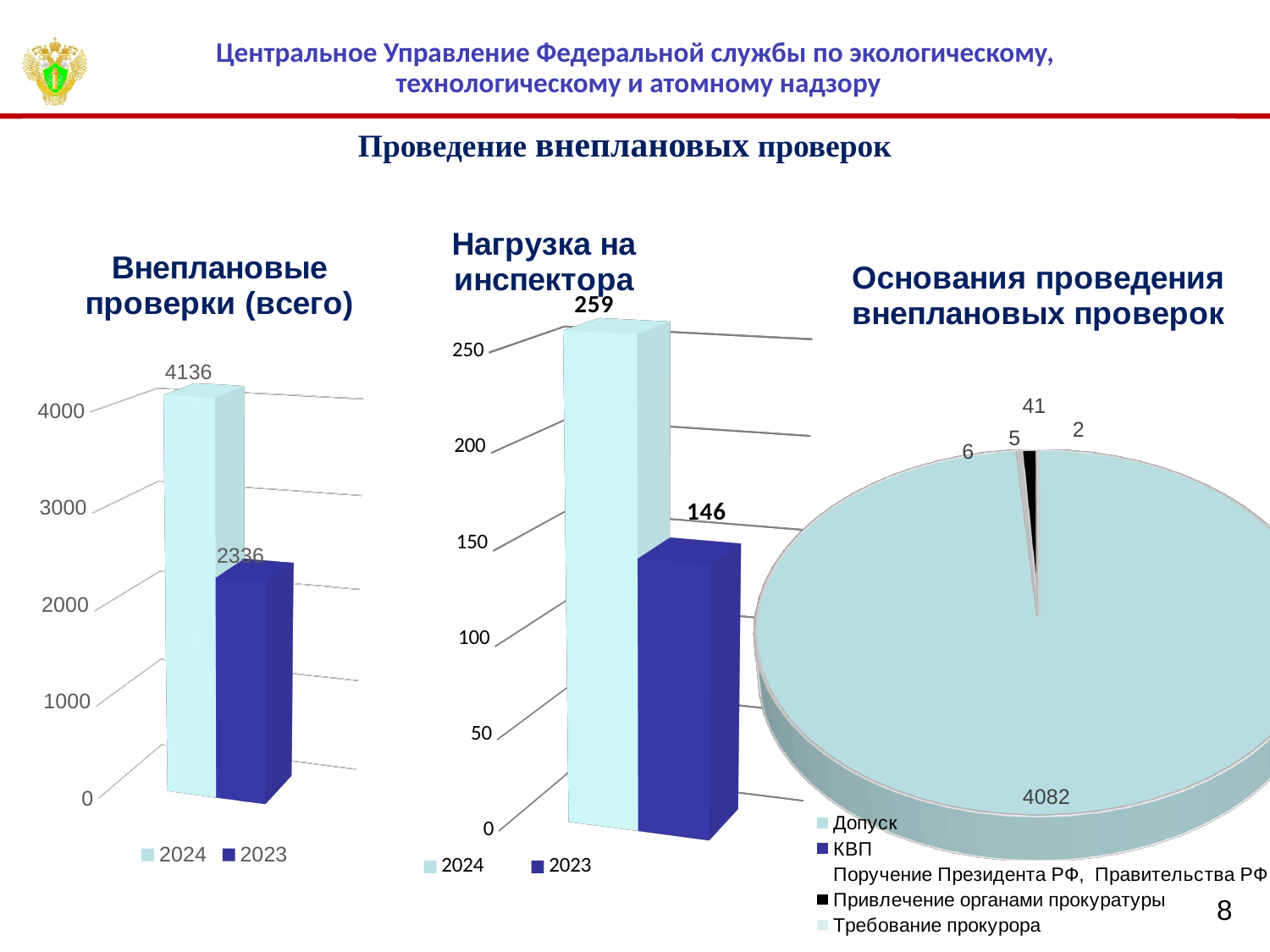
In the chart 'Нагрузка на инспектора', how many series does the legend list? 2 In the chart 'Нагрузка на инспектора', what is the value for 2023? 146 What kind of chart is 'Основания проведения внеплановых проверок'? Pie chart In the chart 'Внеплановые проверки (всего)', what is the value for 2023? 2336 In the chart 'Внеплановые проверки (всего)', which year has the higher value? 2024 In the pie chart 'Основания проведения внеплановых проверок', which category does the largest slice represent? Допуск In the pie chart 'Основания проведения внеплановых проверок', what is the value of the largest slice? 4082 How many categories does the legend of the pie chart 'Основания проведения внеплановых проверок' list? 5 In the chart 'Нагрузка на инспектора', what is the value for 2024? 259 In the chart 'Внеплановые проверки (всего)', what is the difference between the 2024 and 2023 values? 1800 In the chart 'Нагрузка на инспектора', by how much does the 2024 value exceed the 2023 value? 113 In the chart 'Внеплановые проверки (всего)', what is the value for 2024? 4136